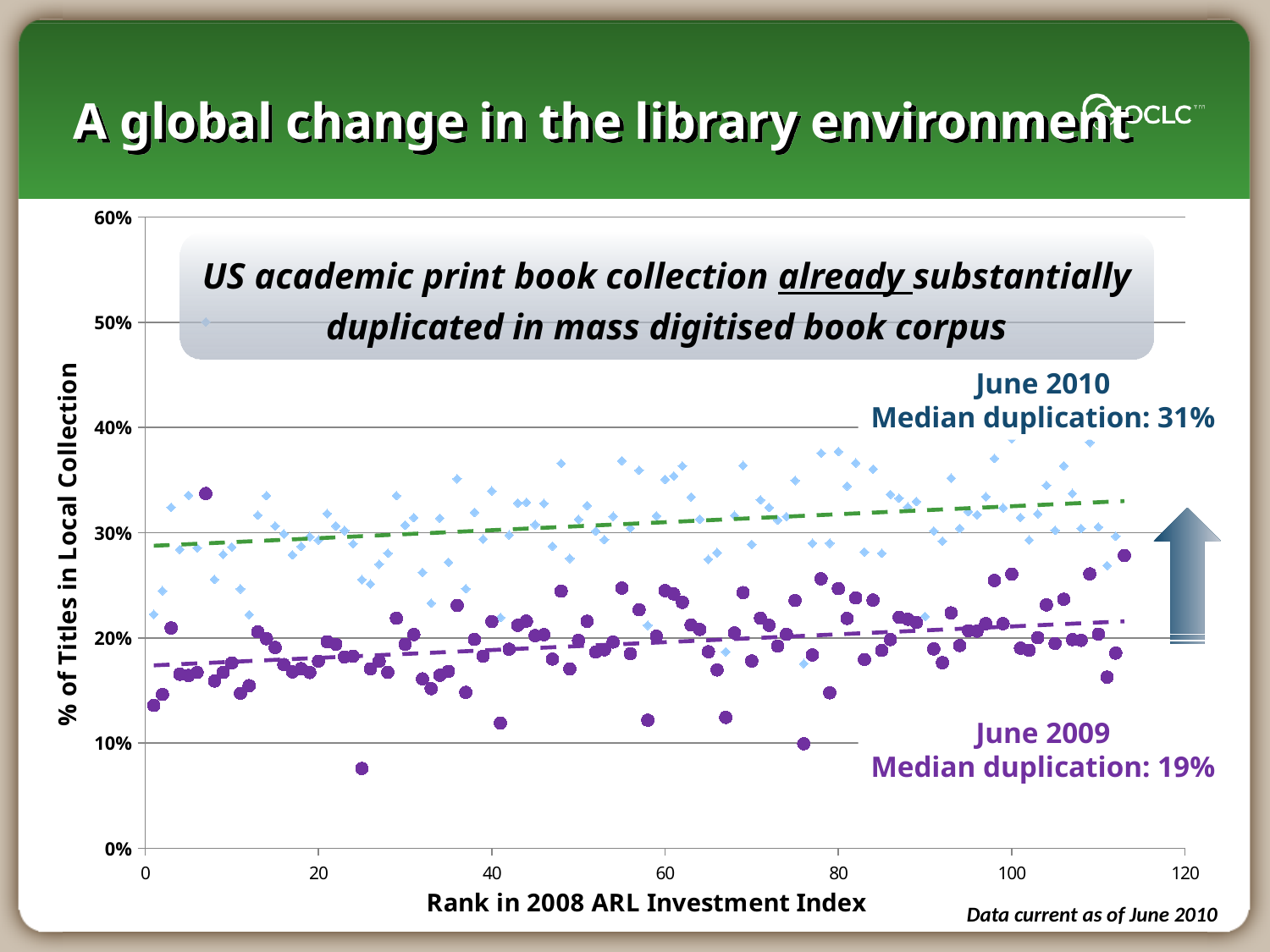
What kind of chart is shown on the slide? Scatter chart Do the dashed trend lines rise or fall as rank increases along the x axis? Rise What is the median duplication for June 2010? 31% What is the maximum value shown on the vertical axis? 60% Is the highest June 2010 value greater or less than 40%? greater What is the label of the horizontal axis? Rank in 2008 ARL Investment Index What is the median duplication for June 2009? 19% How many data series are plotted on the chart? 2 By how many percentage points does the June 2010 median duplication exceed the June 2009 median duplication? 12 percentage points Which year has the higher median duplication, June 2009 or June 2010? June 2010 Is the lowest June 2009 value greater or less than 10%? less What is the label of the vertical axis? % of Titles in Local Collection